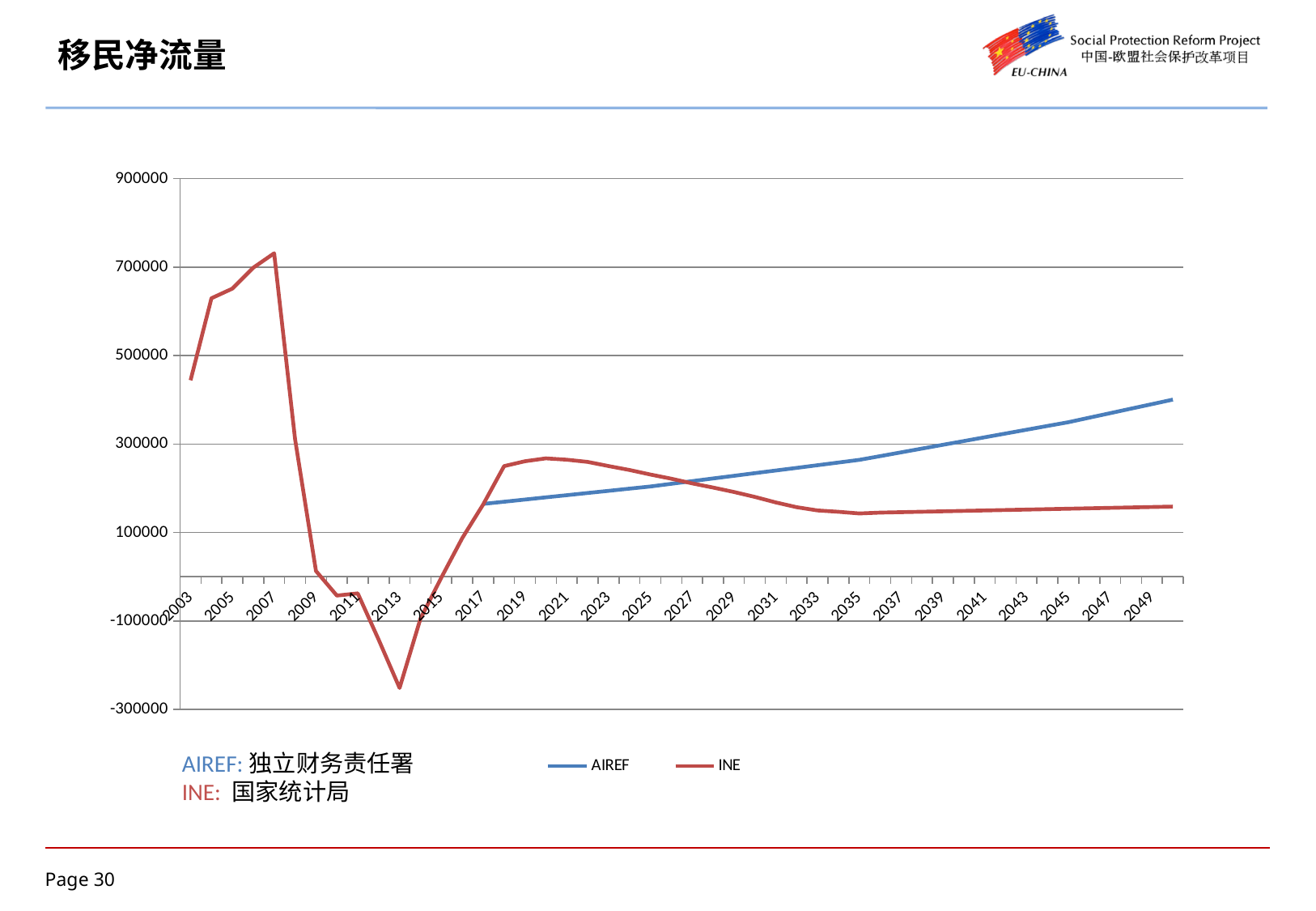
Is the INE value for 2013 greater or less than -100000? less Is the INE value for 2007 greater or less than 500000? greater What kind of chart is shown on the slide? line chart Is the INE value for 2049 greater or less than 300000? less In 2049, which series has the larger value, AIREF or INE? AIREF What is the title of the slide containing the chart? 移民净流量 What are the two series named in the legend? AIREF and INE How many series does the legend list? 2 Does the AIREF series rise or fall from 2017 to 2049? rise In which year does the INE series reach its lowest value? 2013 In which year does the INE series reach its highest value? 2007